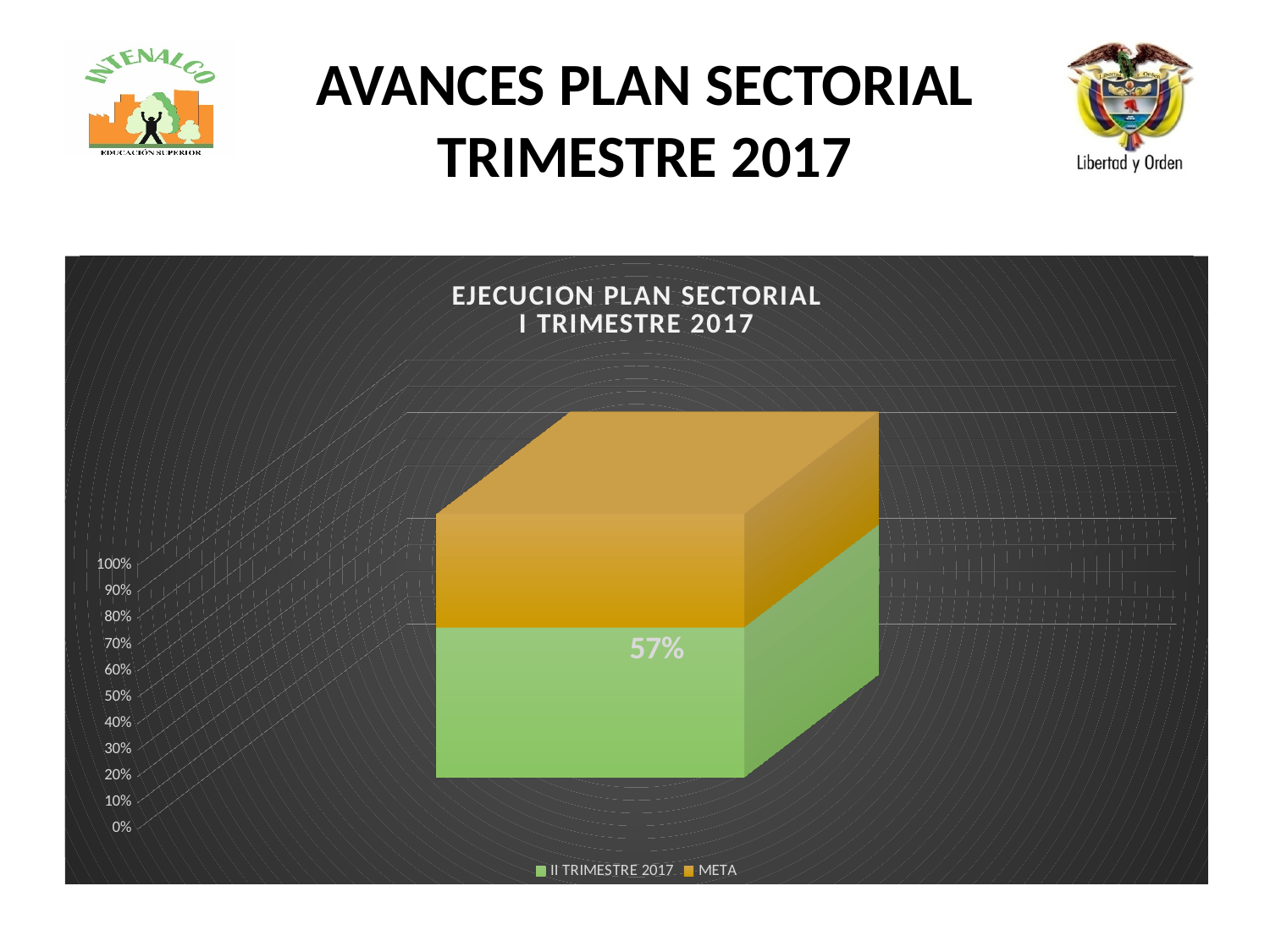
Which series is shown in orange in the legend? META How many bars are plotted in the chart? 1 How many series does the legend list? 2 What is the title of the chart? EJECUCION PLAN SECTORIAL I TRIMESTRE 2017 What is the highest value shown on the vertical axis? 100% Is the value for II TRIMESTRE 2017 greater or less than 50%? greater What is the value shown for II TRIMESTRE 2017? 57% Is the value for II TRIMESTRE 2017 greater or less than 60%? less What kind of chart is shown on the slide? Bar chart